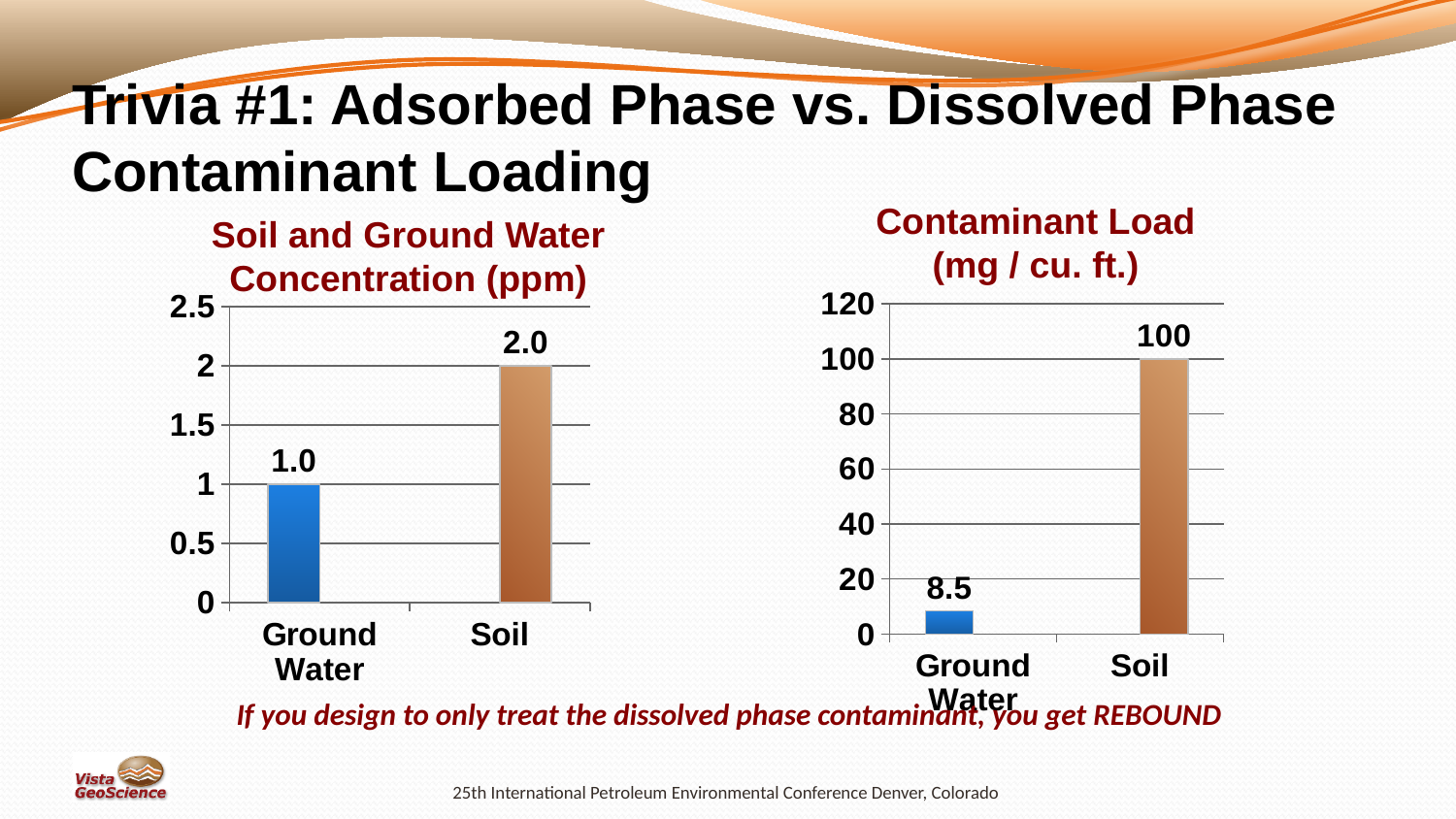
How many categories are shown in the 'Contaminant Load (mg / cu. ft.)' chart? 2 In the 'Soil and Ground Water Concentration (ppm)' chart, which category has the lowest value? Ground Water In the 'Soil and Ground Water Concentration (ppm)' chart, what is the value for Soil? 2.0 In the 'Contaminant Load (mg / cu. ft.)' chart, which category has the highest value? Soil What kind of chart is the 'Soil and Ground Water Concentration (ppm)' chart? bar chart In the 'Contaminant Load (mg / cu. ft.)' chart, what is the difference between the Soil and Ground Water values? 91.5 In the 'Soil and Ground Water Concentration (ppm)' chart, what is the difference between the Soil and Ground Water values? 1.0 In the 'Soil and Ground Water Concentration (ppm)' chart, what is the value for Ground Water? 1.0 In the 'Contaminant Load (mg / cu. ft.)' chart, what is the value for Soil? 100 In the 'Soil and Ground Water Concentration (ppm)' chart, which is larger, the value for Soil or the value for Ground Water? Soil In the 'Contaminant Load (mg / cu. ft.)' chart, what is the value for Ground Water? 8.5 In the 'Contaminant Load (mg / cu. ft.)' chart, is the value for Ground Water greater or less than 20? less